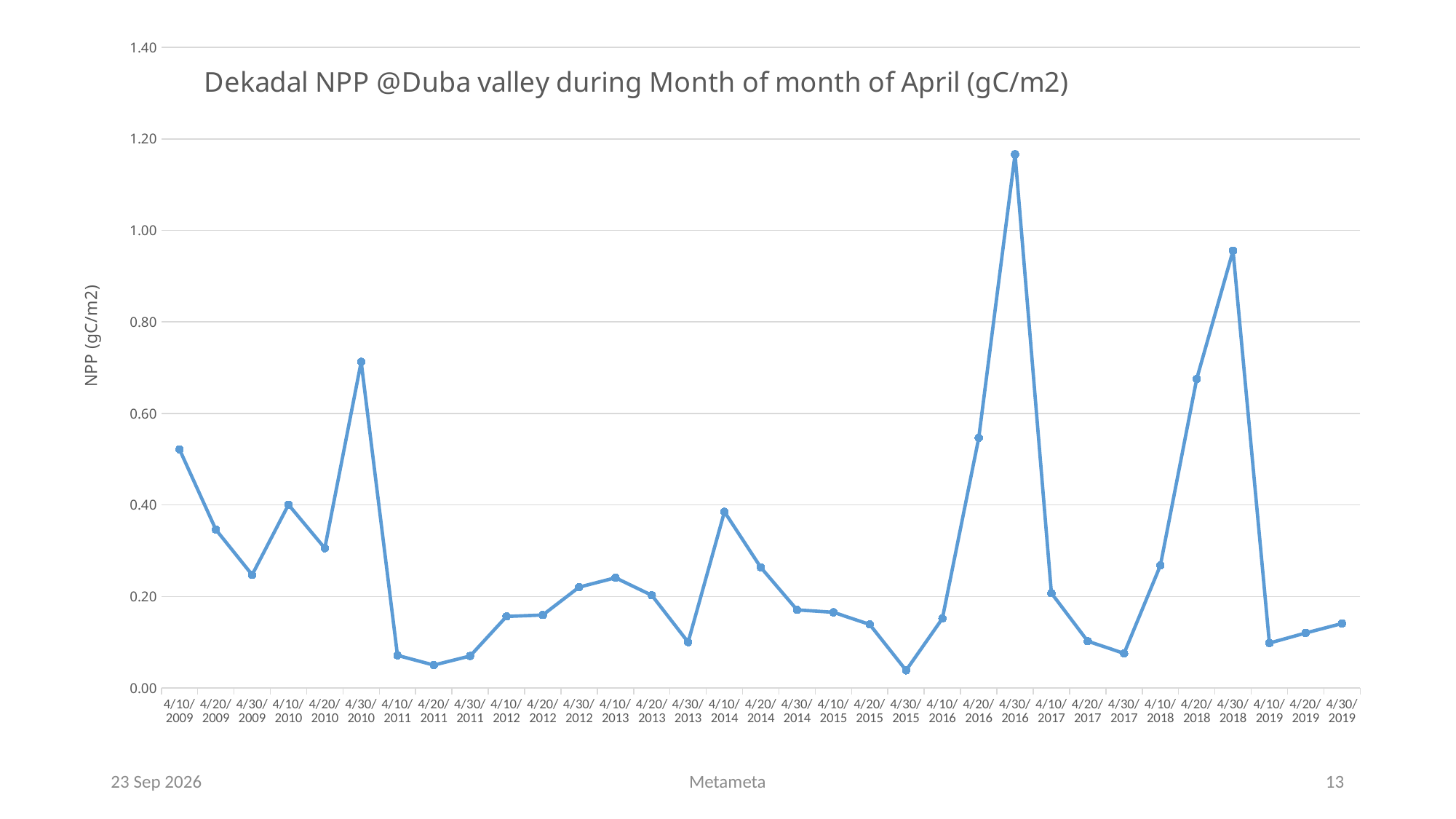
What kind of chart is shown on the slide? Line chart Which date has the highest NPP value? 4/30/2016 Which is larger, the value for 4/30/2016 or the value for 4/30/2018? 4/30/2016 Is the value for 4/30/2016 greater or less than 1.00? greater What is the label on the vertical axis of the chart? NPP (gC/m2) Is the value for 4/30/2010 greater or less than 0.60? greater Do the values rise or fall from 4/10/2009 to 4/30/2009? fall How many data points are plotted on the line? 33 What is the title of the chart? Dekadal NPP @Duba valley during Month of month of April (gC/m2) Is the value for 4/30/2015 greater or less than 0.20? less Which is larger, the value for 4/30/2010 or the value for 4/10/2009? 4/30/2010